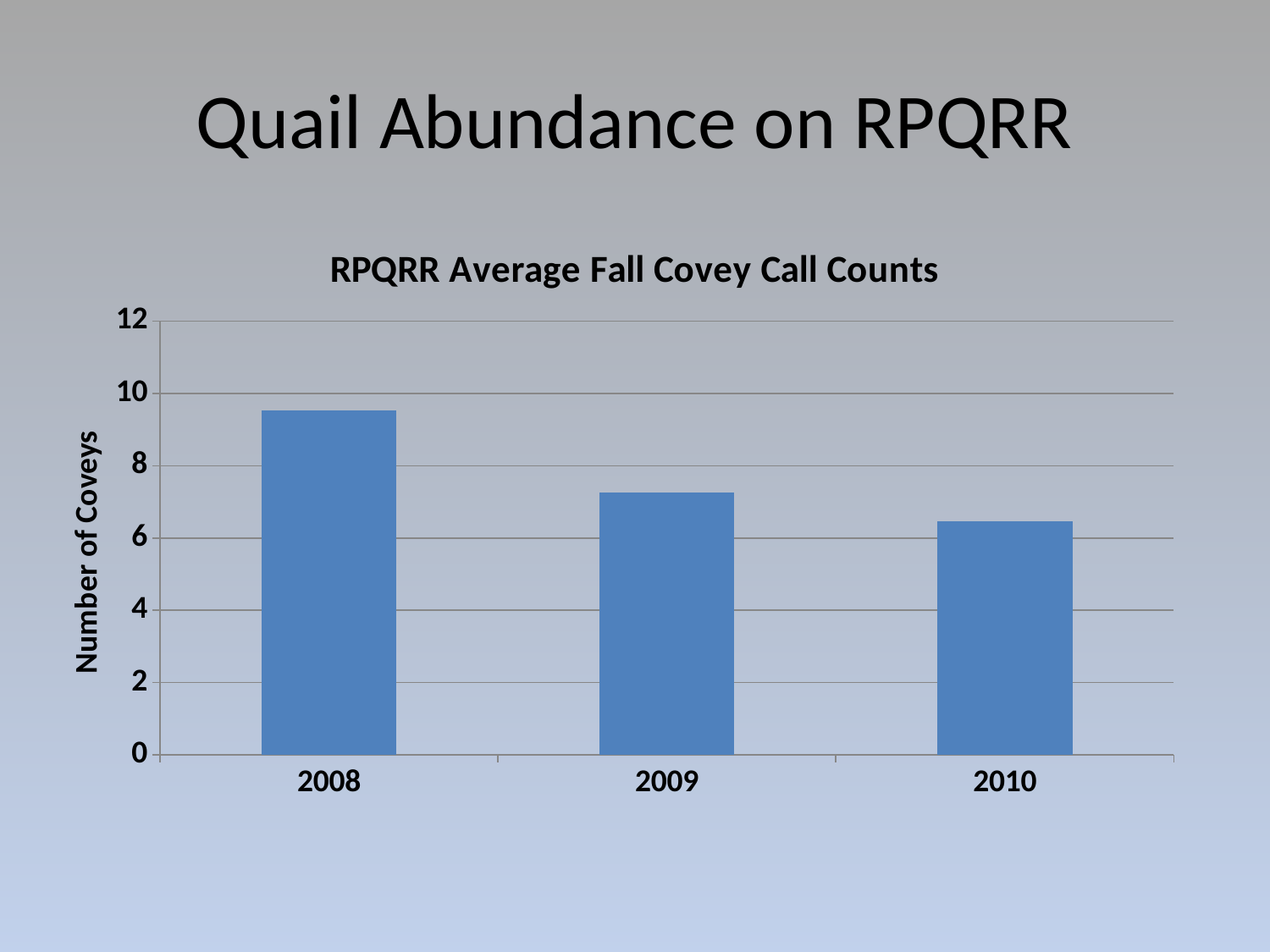
Do the values rise or fall from 2008 to 2010? fall Is the value for 2009 greater or less than 8? less Which year has the lowest average fall covey call count? 2010 What is the label on the vertical axis of the chart? Number of Coveys Which year has a higher value, 2009 or 2010? 2009 How many years are shown on the x axis of the chart? 3 Which year has a higher value, 2008 or 2009? 2008 What kind of chart is shown on the slide? bar chart What is the title of the chart? RPQRR Average Fall Covey Call Counts Which year has the highest average fall covey call count? 2008 Is the value for 2008 greater or less than 8? greater Is the value for 2010 greater or less than 8? less